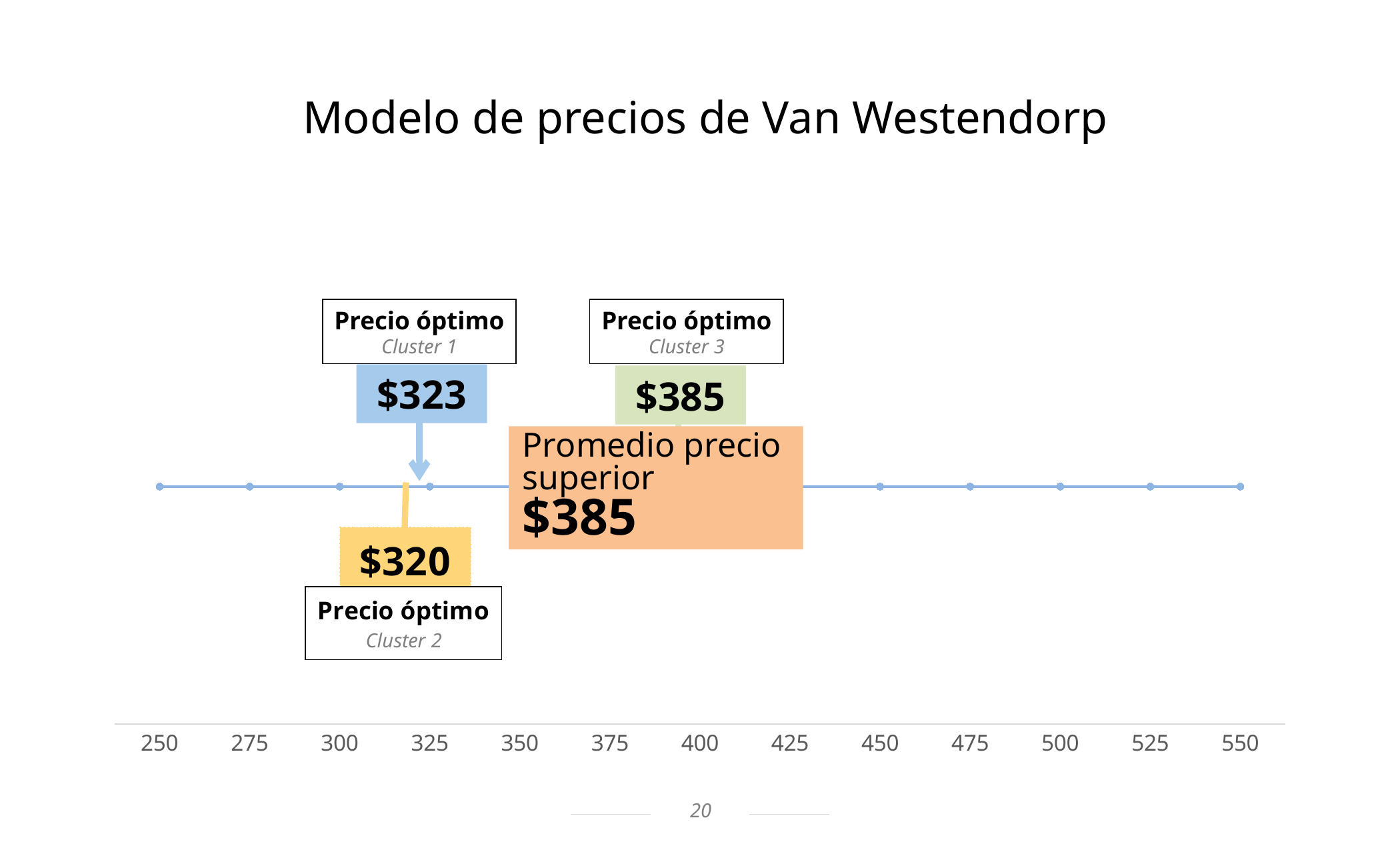
Which is larger, the optimal price for Cluster 1 or for Cluster 2? Cluster 1 What value is shown for 'Promedio precio superior'? $385 What is the lowest value shown on the horizontal axis? 250 Which cluster has the highest optimal price? Cluster 3 What is the difference between the optimal price of Cluster 3 and that of Cluster 1? $62 What is the optimal price (Precio óptimo) for Cluster 3? $385 Is the optimal price for Cluster 3 greater or less than 350? greater What is the optimal price (Precio óptimo) for Cluster 2? $320 What is the title of the chart on the slide? Modelo de precios de Van Westendorp What is the difference between the optimal price of Cluster 1 and that of Cluster 2? $3 What is the optimal price (Precio óptimo) for Cluster 1? $323 Which cluster has the lowest optimal price? Cluster 2